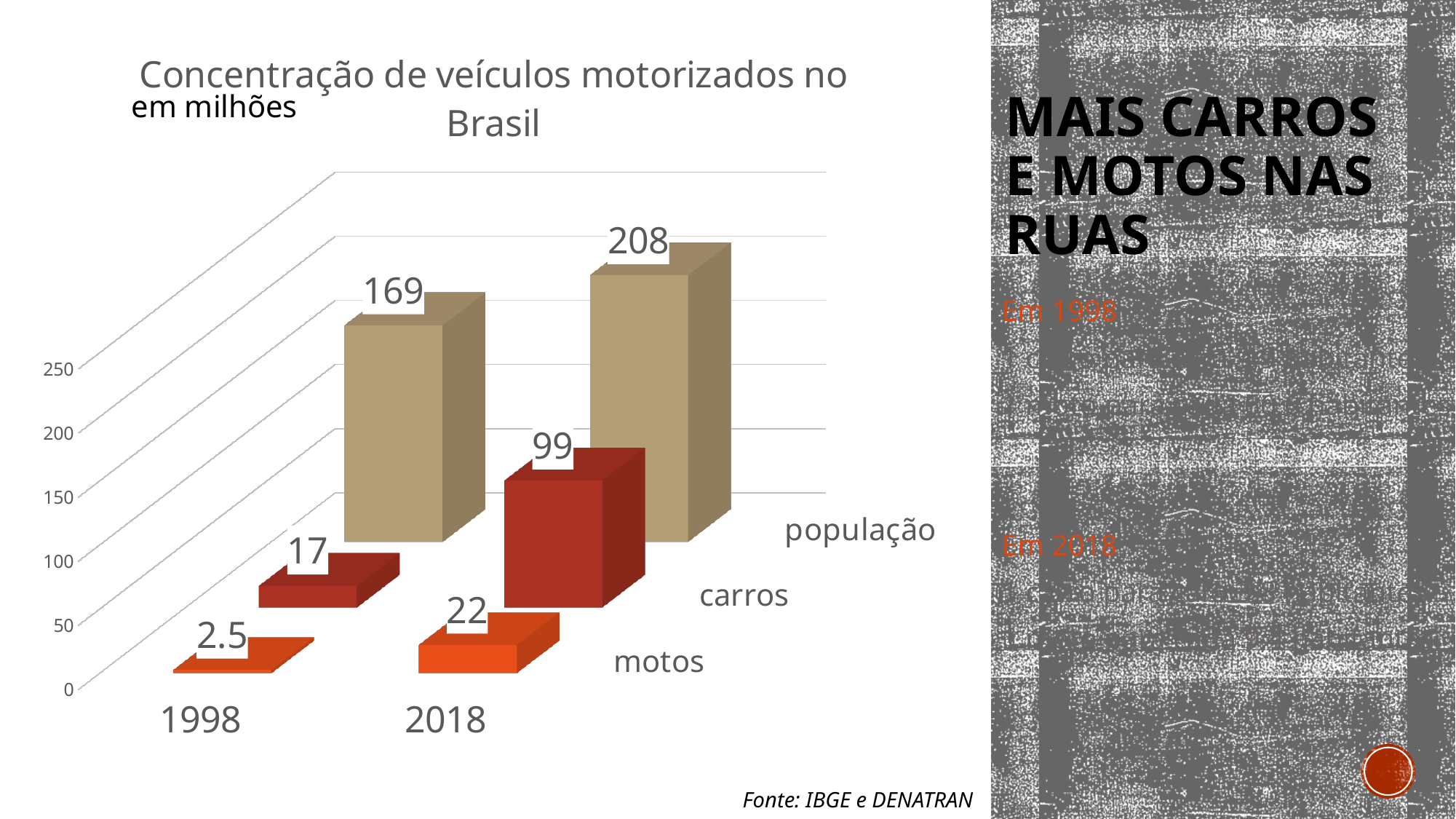
What is the title of the chart? Concentração de veículos motorizados no Brasil Which series has the lowest value in 1998? motos What kind of chart is shown on the slide? bar chart How many years are shown on the x axis? 2 Which series has the highest value in 2018? população What is the value for carros in 2018? 99 What is the value for população in 2018? 208 What is the value for motos in 1998? 2.5 Which is larger, the value for motos in 2018 or the value for carros in 1998? motos in 2018 What is the difference between the população values for 2018 and 1998? 39 What is the difference between the carros values for 2018 and 1998? 82 What is the value for população in 1998? 169